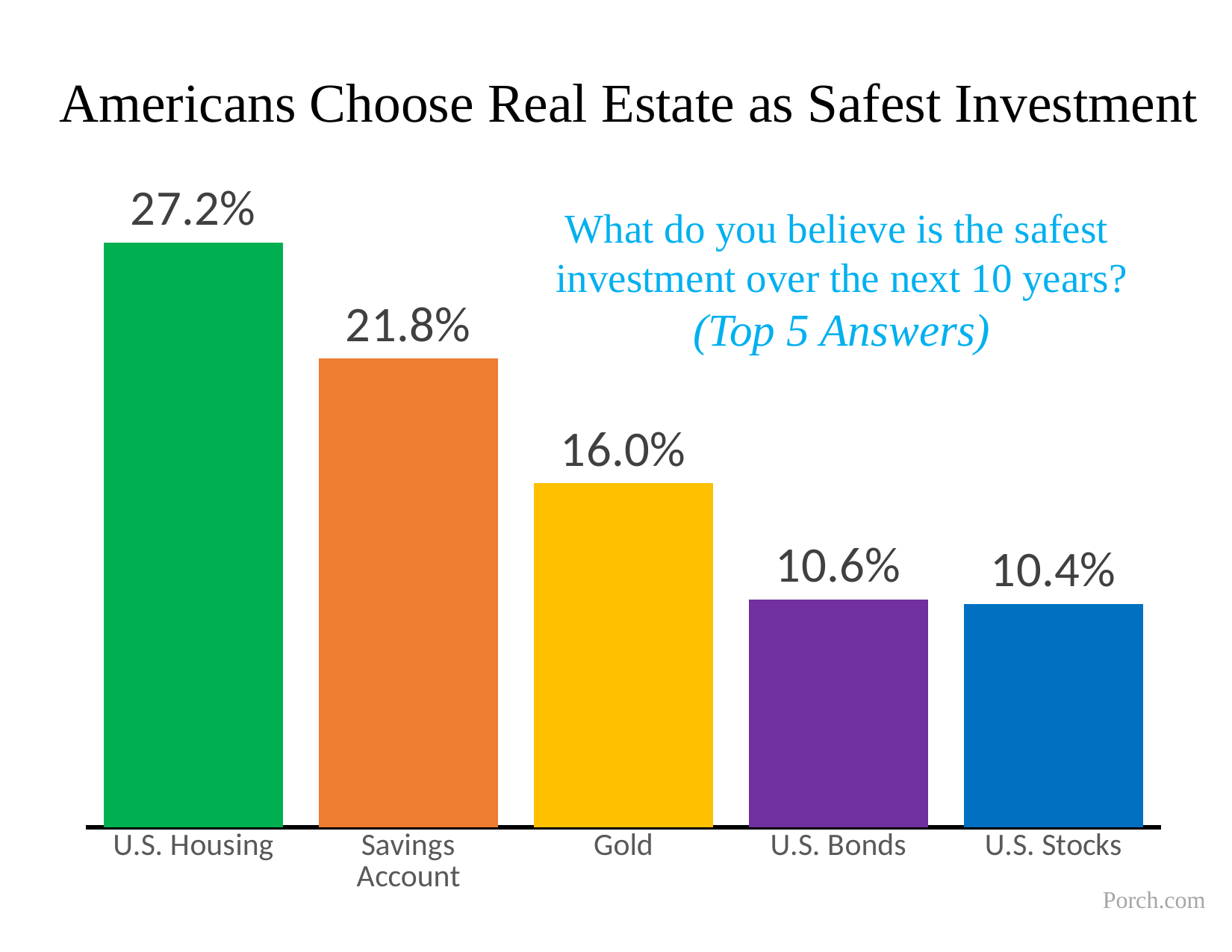
Which is larger, the value for Savings Account or the value for Gold? Savings Account What is the difference between the values for U.S. Housing and Savings Account? 5.4% What is the value shown for Savings Account? 21.8% What is the difference between the values for Gold and U.S. Bonds? 5.4% What is the value shown for Gold? 16.0% Which category has the highest value? U.S. Housing What kind of chart is shown on the slide? Bar chart Which category has the lowest value? U.S. Stocks What is the value shown for U.S. Stocks? 10.4% How many categories are shown in the chart? 5 What is the title of the slide? Americans Choose Real Estate as Safest Investment What percentage of respondents chose U.S. Housing as the safest investment? 27.2%